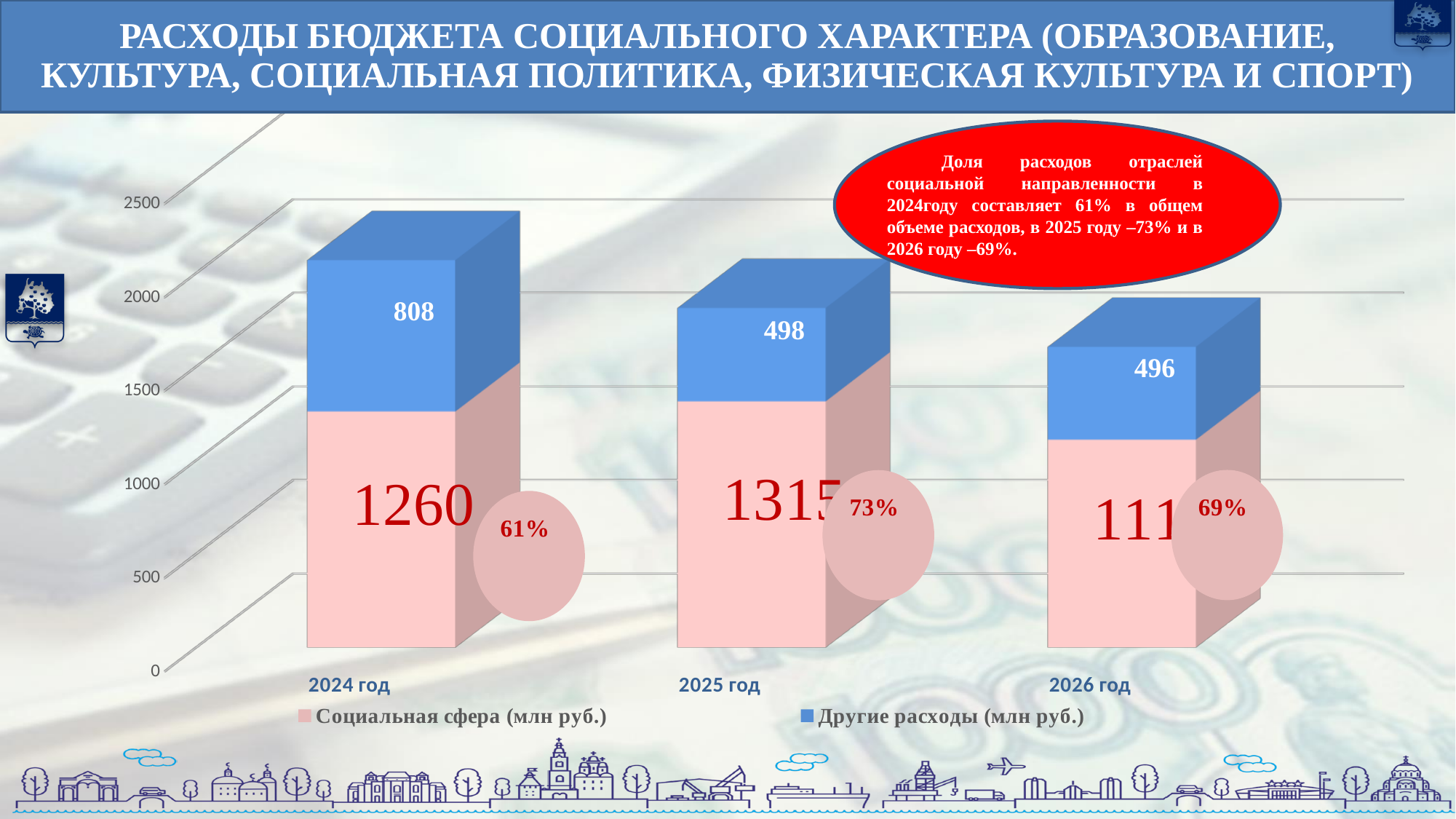
What is the difference between Другие расходы in 2024 год and in 2025 год? 310 What is the value of Другие расходы (млн руб.) for 2024 год? 808 What kind of chart is shown on the slide? stacked bar chart What is the total of the stacked bar for 2025 год? 1813 What is the total of the stacked bar for 2024 год? 2068 How many series does the legend list? 2 What is the value of Социальная сфера (млн руб.) for 2025 год? 1315 Which year has the highest value for Другие расходы (млн руб.)? 2024 год How many years are shown on the x axis? 3 Which is larger: Социальная сфера in 2024 год or in 2025 год? 2025 год What share is shown in the circle next to the 2025 год bar? 73% What is the value of Другие расходы (млн руб.) for 2026 год? 496